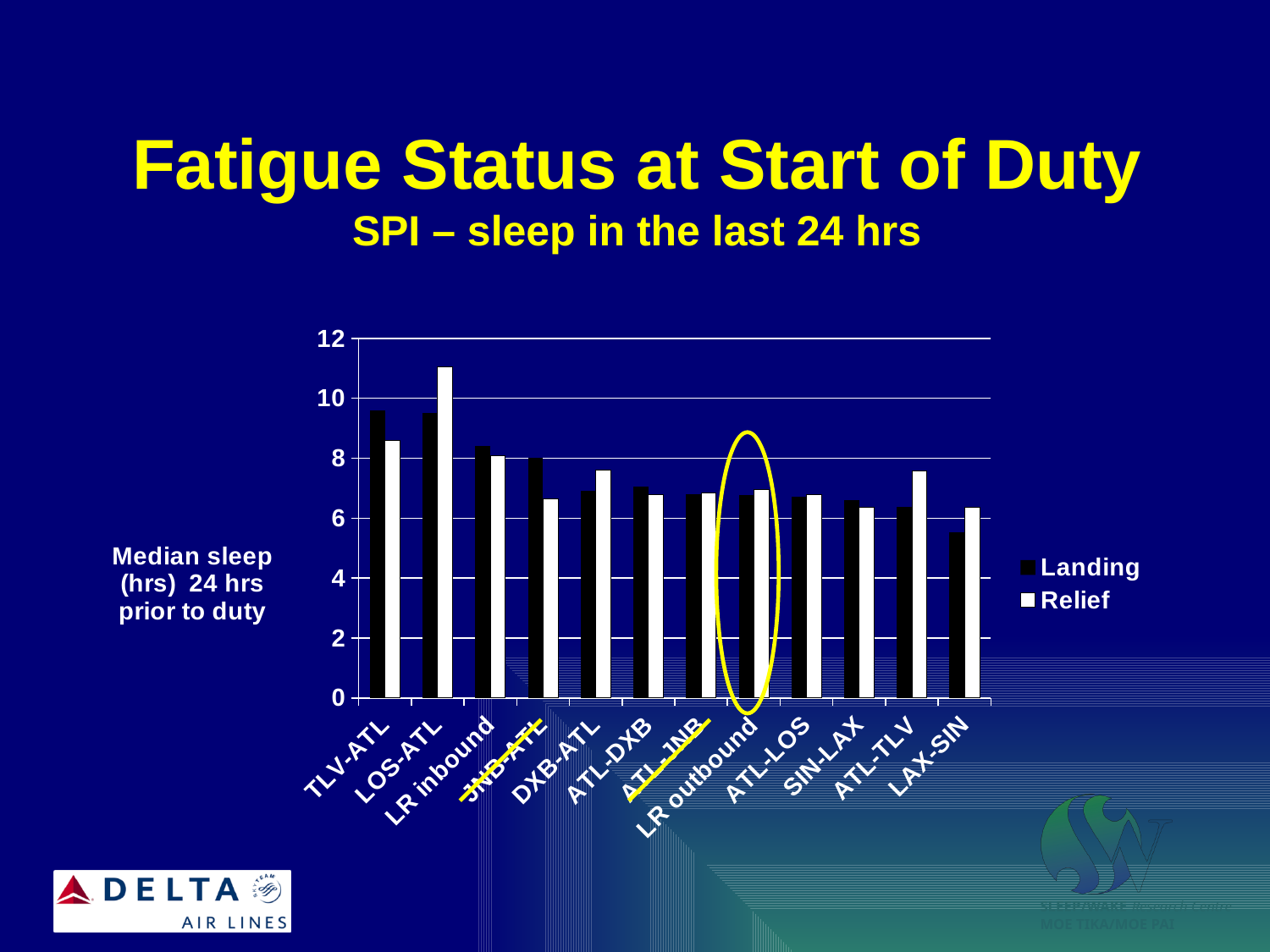
Which category has the lowest Landing value? LAX-SIN Is the Landing value for TLV-ATL greater or less than 8? greater How many series does the legend list? 2 For JNB-ATL, which is larger, the Landing value or the Relief value? Landing Is the Relief value for LOS-ATL greater or less than 10? greater What is the label on the vertical axis of the chart? Median sleep (hrs) 24 hrs prior to duty For ATL-TLV, which is larger, the Landing value or the Relief value? Relief Is the Landing value for LAX-SIN greater or less than 6? less How many categories are shown along the x axis? 12 Which category has the highest Relief value? LOS-ATL What kind of chart is shown on the slide? bar chart Which series is shown with black bars? Landing